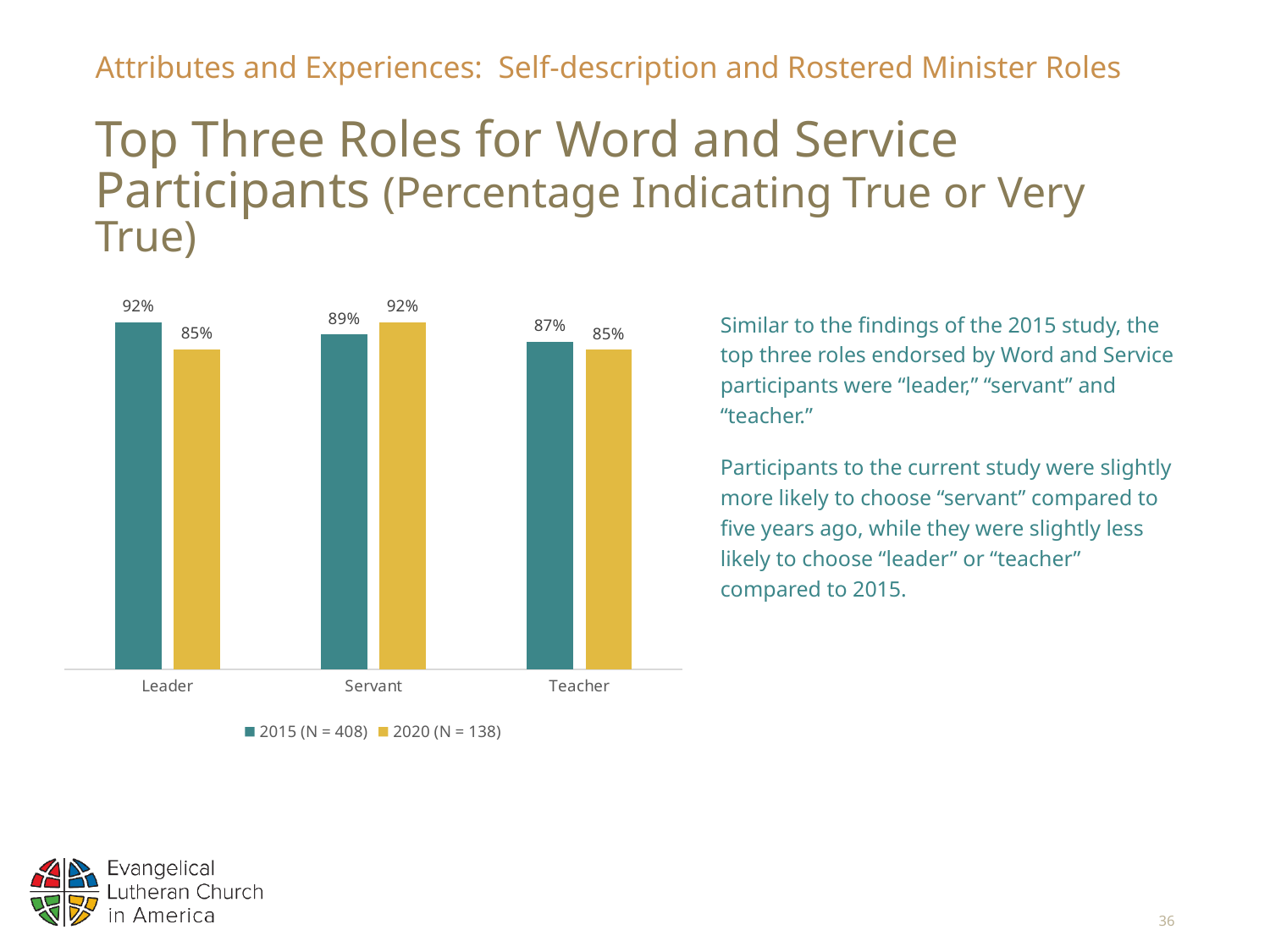
What is the difference between the 2015 and 2020 values for 'Leader'? 7% What is the value for 'Leader' in the 2020 (N = 138) series? 85% Which role has the lowest value in the 2015 (N = 408) series? Teacher What kind of chart is shown on the slide? Bar chart How many roles are shown on the x axis of the chart? 3 What percentage of 2015 participants indicated 'Leader' was true or very true? 92% What is the value for 'Teacher' in the 2015 (N = 408) series? 87% Which role has the highest value in the 2020 (N = 138) series? Servant How many series does the chart's legend list? 2 Which role has the highest value in the 2015 (N = 408) series? Leader Which is larger for 'Servant': the 2015 value or the 2020 value? 2020 What is the value for 'Servant' in the 2020 (N = 138) series? 92%